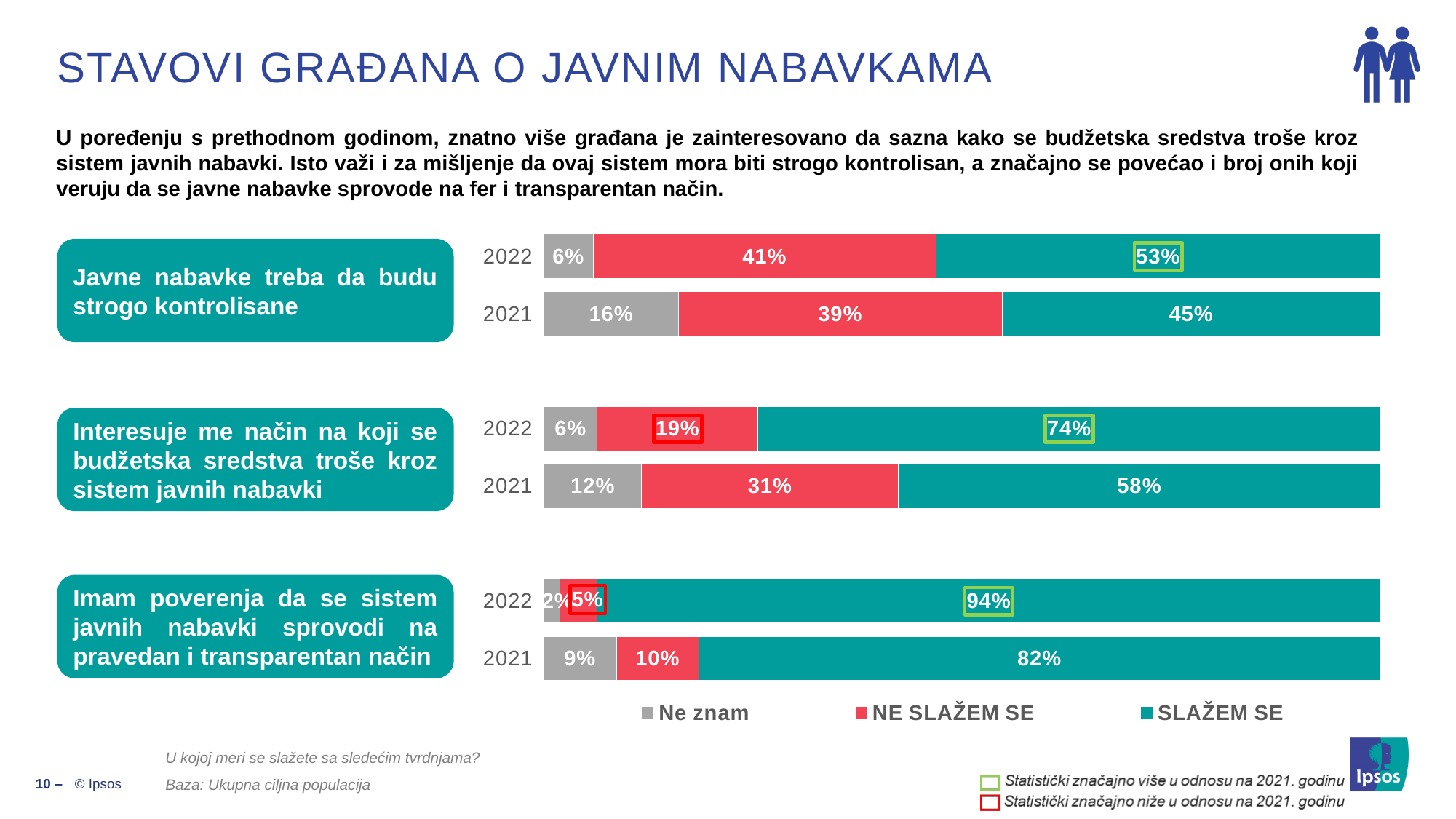
In the chart for "Javne nabavke treba da budu strogo kontrolisane", which year has the larger NE SLAŽEM SE value, 2022 or 2021? 2022 In the chart for "Imam poverenja da se sistem javnih nabavki sprovodi na pravedan i transparentan način", what is the SLAŽEM SE value for 2022? 94% In the chart for "Javne nabavke treba da budu strogo kontrolisane", what is the Ne znam value for 2021? 16% In the chart for "Javne nabavke treba da budu strogo kontrolisane", what is the SLAŽEM SE value for 2022? 53% In the chart for "Interesuje me način na koji se budžetska sredstva troše kroz sistem javnih nabavki", what is the SLAŽEM SE value for 2021? 58% Which legend entry is shown in teal? SLAŽEM SE In the chart for "Interesuje me način na koji se budžetska sredstva troše kroz sistem javnih nabavki", what is the NE SLAŽEM SE value for 2022? 19% In the chart for "Imam poverenja da se sistem javnih nabavki sprovodi na pravedan i transparentan način", what is the difference between the SLAŽEM SE values for 2022 and 2021? 12% In the chart for "Imam poverenja da se sistem javnih nabavki sprovodi na pravedan i transparentan način", which segment is the smallest in the 2022 bar? Ne znam How many series does the legend list? 3 In the chart for "Interesuje me način na koji se budžetska sredstva troše kroz sistem javnih nabavki", by how much did the SLAŽEM SE value change from 2021 to 2022? 16% What kind of chart is used on this slide? Stacked bar chart